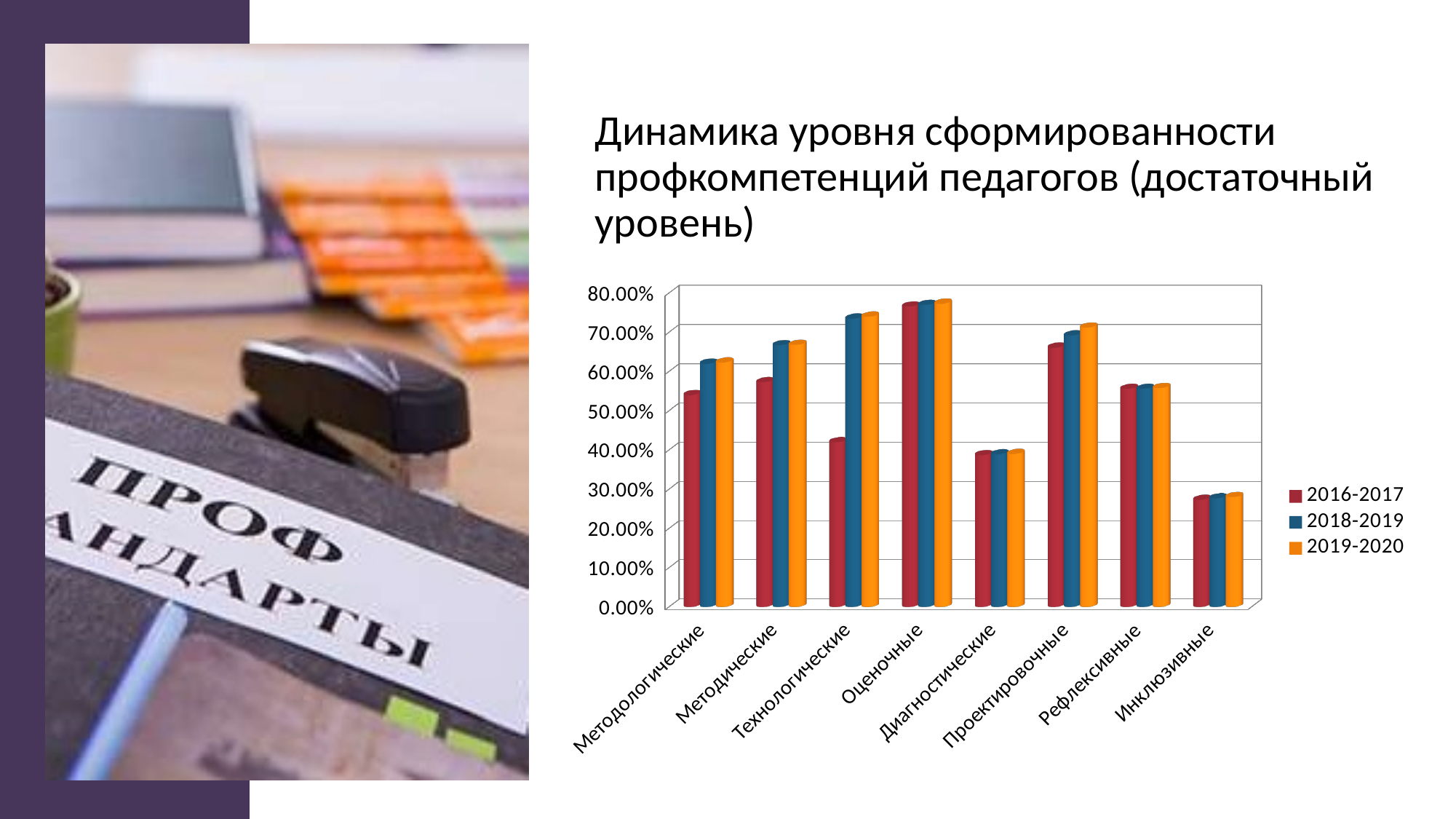
Is the value for Оценочные in 2019-2020 greater or less than 70.00%? greater Which category has the lowest value for the 2019-2020 series? Инклюзивные Is the value for Диагностические in 2016-2017 greater or less than 40.00%? less Which is larger for the 2018-2019 series: Методические or Технологические? Технологические How many series does the chart legend list? 3 Is the value for Инклюзивные in 2019-2020 greater or less than 30.00%? less Which series is shown in orange in the chart legend? 2019-2020 What type of chart is shown on the slide? bar chart For Методологические, which series has the larger value: 2016-2017 or 2018-2019? 2018-2019 How many categories are shown on the x axis of the chart? 8 Which category has the highest value for the 2016-2017 series? Оценочные